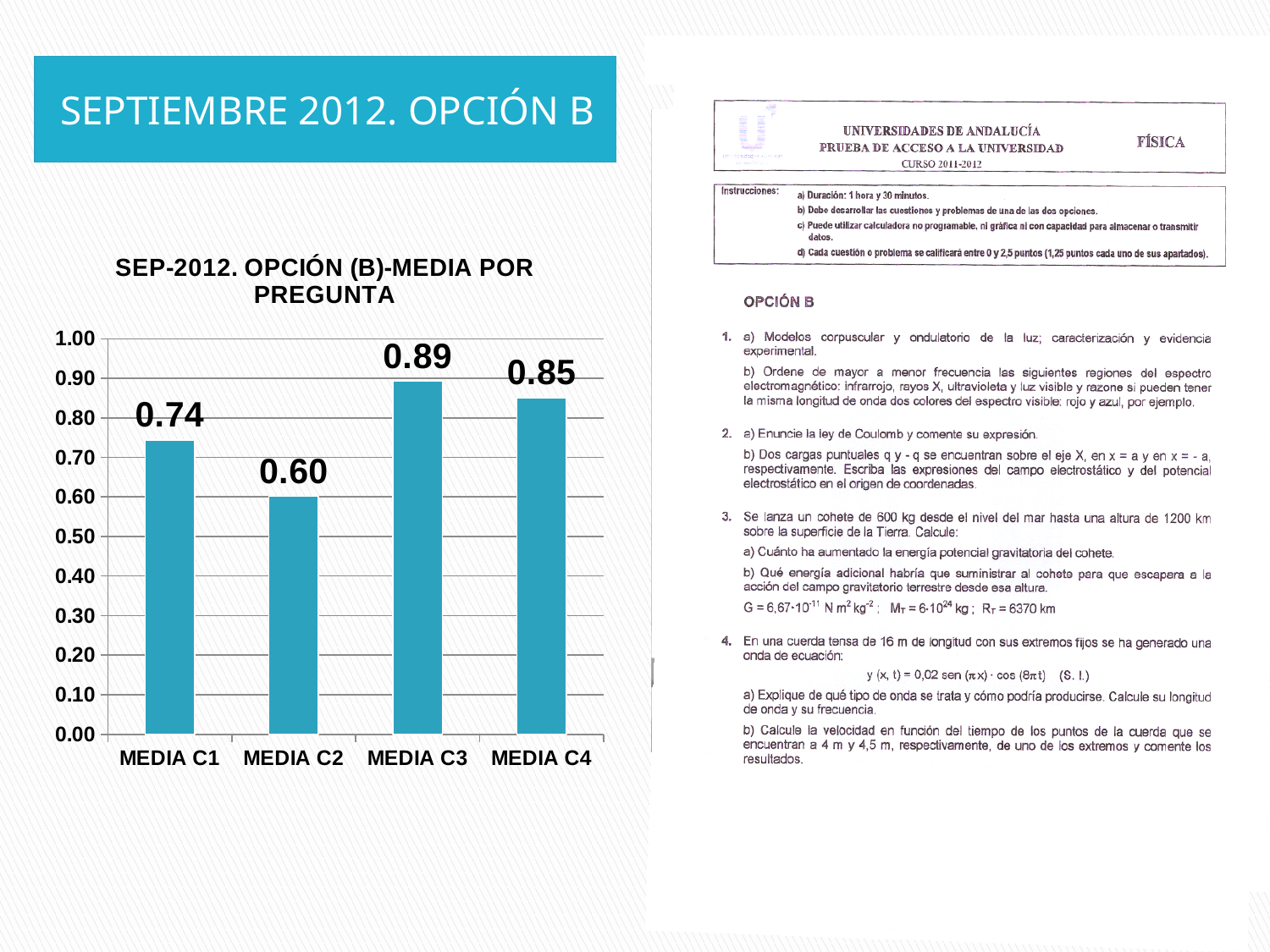
Is the value for MEDIA C2 greater or less than 0.70? less Which category has the highest value? MEDIA C3 What is the value for MEDIA C2? 0.60 What is the title of the chart? SEP-2012. OPCIÓN (B)-MEDIA POR PREGUNTA What is the value for MEDIA C3? 0.89 What kind of chart is shown on the slide? bar chart Which is larger, the value for MEDIA C1 or the value for MEDIA C4? MEDIA C4 What is the value for MEDIA C4? 0.85 How many categories are shown in the chart? 4 Which category has the lowest value? MEDIA C2 What is the difference between the values for MEDIA C3 and MEDIA C2? 0.29 What is the value for MEDIA C1? 0.74